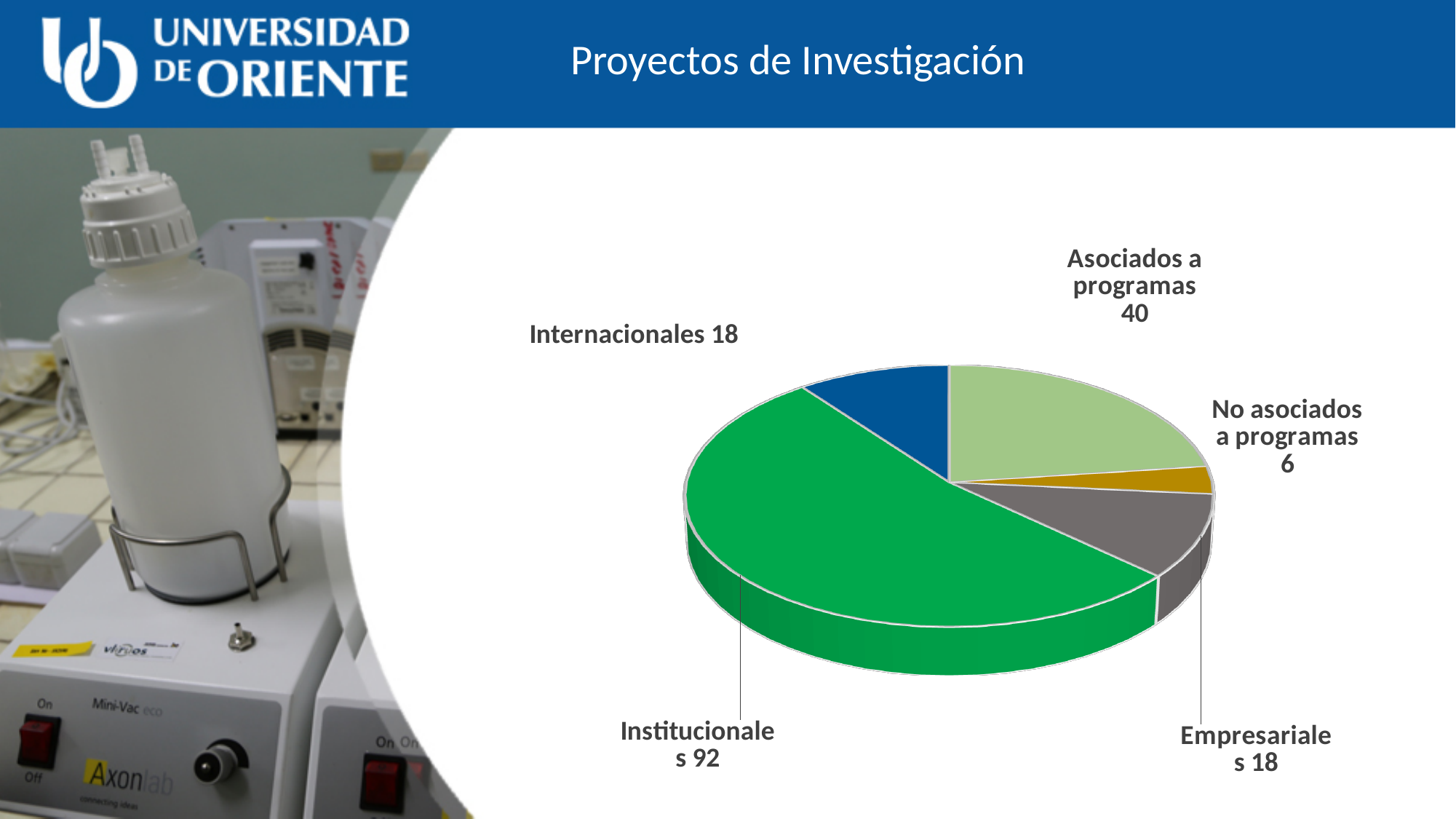
What is the difference between the values for Institucionales and Asociados a programas? 52 Which is larger, Asociados a programas or Empresariales? Asociados a programas What is the total of all the values shown in the pie chart? 174 What kind of chart is shown on the slide? Pie chart What is the value for Internacionales in the pie chart? 18 What is the value for Institucionales in the pie chart? 92 Which category has the smallest slice in the pie chart? No asociados a programas How many slices does the pie chart have? 5 What is the title of the slide containing the pie chart? Proyectos de Investigación Which category has the largest slice in the pie chart? Institucionales What is the value for Asociados a programas in the pie chart? 40 What is the value for No asociados a programas in the pie chart? 6